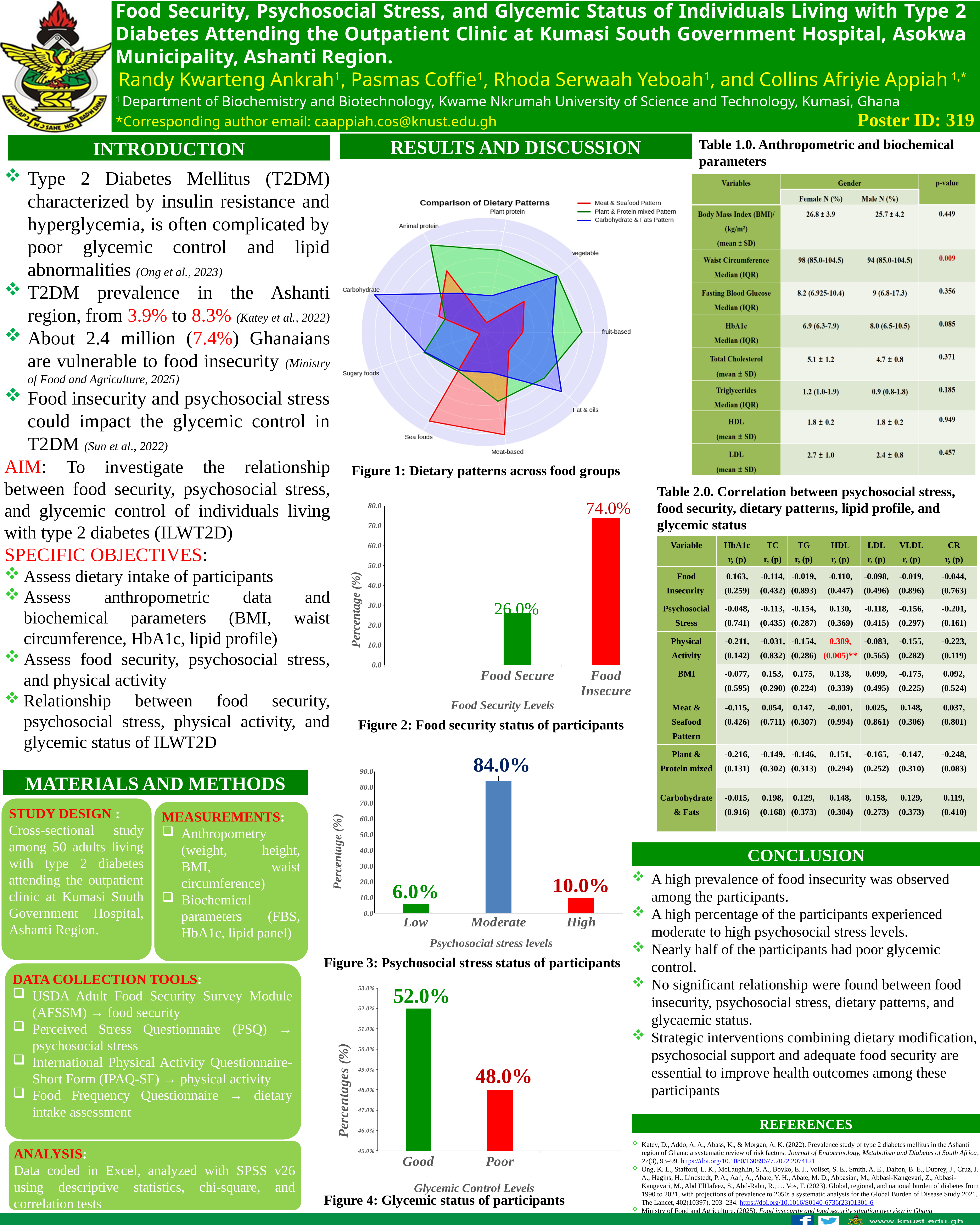
In Figure 3 (Psychosocial stress status of participants), how many stress level categories are shown on the x axis? 3 In Figure 4 (Glycemic status of participants), what kind of chart is used? Bar chart In Figure 3 (Psychosocial stress status of participants), what percentage of participants had Moderate stress? 84.0% In Figure 2 (Food security status of participants), what percentage of participants were Food Insecure? 74.0% In Figure 4 (Glycemic status of participants), what is the difference between the Good and Poor percentages? 4.0% In Figure 4 (Glycemic status of participants), what percentage of participants had Good glycemic control? 52.0% In Figure 2 (Food security status of participants), what percentage of participants were Food Secure? 26.0% In Figure 1 (Dietary patterns across food groups), which colour represents the Carbohydrate & Fats Pattern? Blue In Figure 3 (Psychosocial stress status of participants), which is larger, the percentage for Low or for High? High In Figure 1 (Dietary patterns across food groups), how many dietary patterns does the legend list? 3 In Figure 2 (Food security status of participants), what is the difference between the Food Insecure and Food Secure percentages? 48.0% In Figure 3 (Psychosocial stress status of participants), which stress level has the lowest percentage? Low